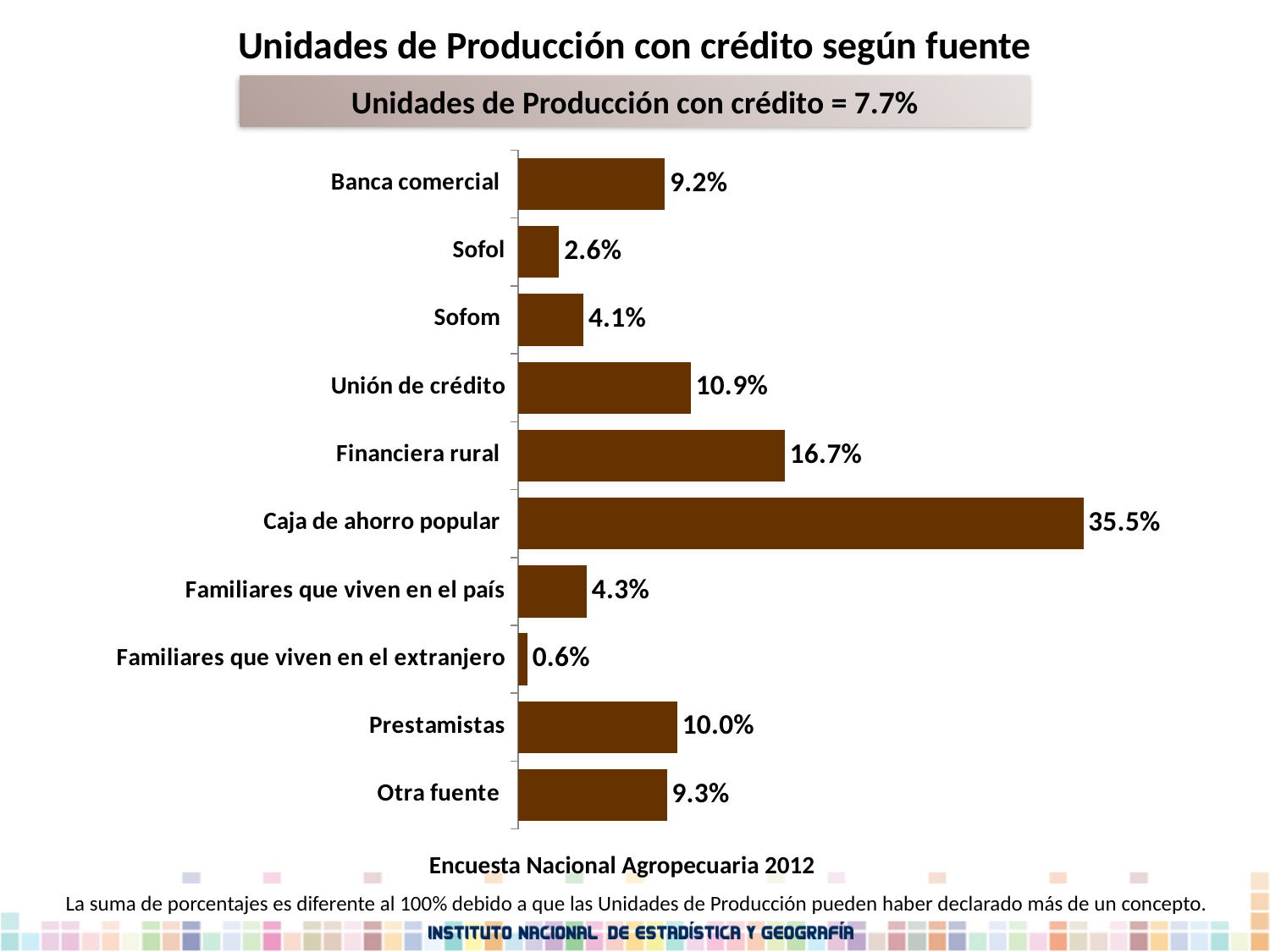
What kind of chart is shown on the slide? Bar chart What is the value for Familiares que viven en el extranjero? 0.6% What is the value for Financiera rural? 16.7% What is the difference between the values for Unión de crédito and Prestamistas? 0.9% Which category has the lowest value? Familiares que viven en el extranjero What percentage of Unidades de Producción con crédito is stated in the banner above the chart? 7.7% What is the difference between the values for Caja de ahorro popular and Financiera rural? 18.8% Which is larger, the value for Banca comercial or the value for Otra fuente? Otra fuente What is the value for Sofom? 4.1% How many categories are shown in the chart? 10 What is the value for Caja de ahorro popular? 35.5% Which category has the highest value? Caja de ahorro popular